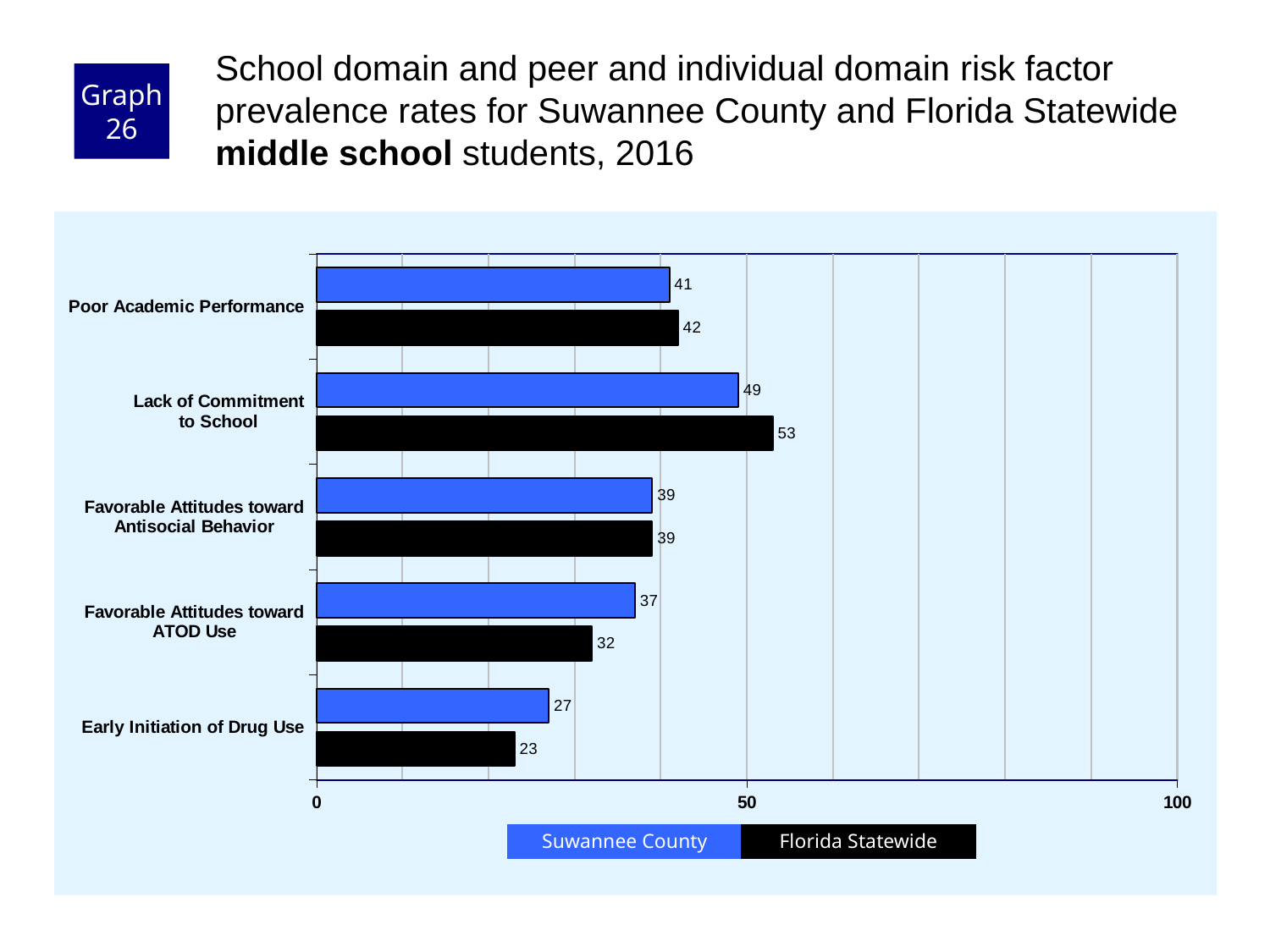
Is the Suwannee County value for Poor Academic Performance greater or less than 50? less What is the Florida Statewide value for Favorable Attitudes toward ATOD Use? 32 How many series does the legend list? 2 What is the Florida Statewide value for Early Initiation of Drug Use? 23 Which risk factor has the lowest Suwannee County value? Early Initiation of Drug Use How many risk factors are shown on the chart? 5 Which colour represents Florida Statewide in the chart? black Which risk factor has the highest Florida Statewide value? Lack of Commitment to School For Favorable Attitudes toward ATOD Use, which is larger: Suwannee County or Florida Statewide? Suwannee County What is the difference between the Florida Statewide and Suwannee County values for Lack of Commitment to School? 4 What is the Suwannee County value for Lack of Commitment to School? 49 What kind of chart is shown on the slide? bar chart